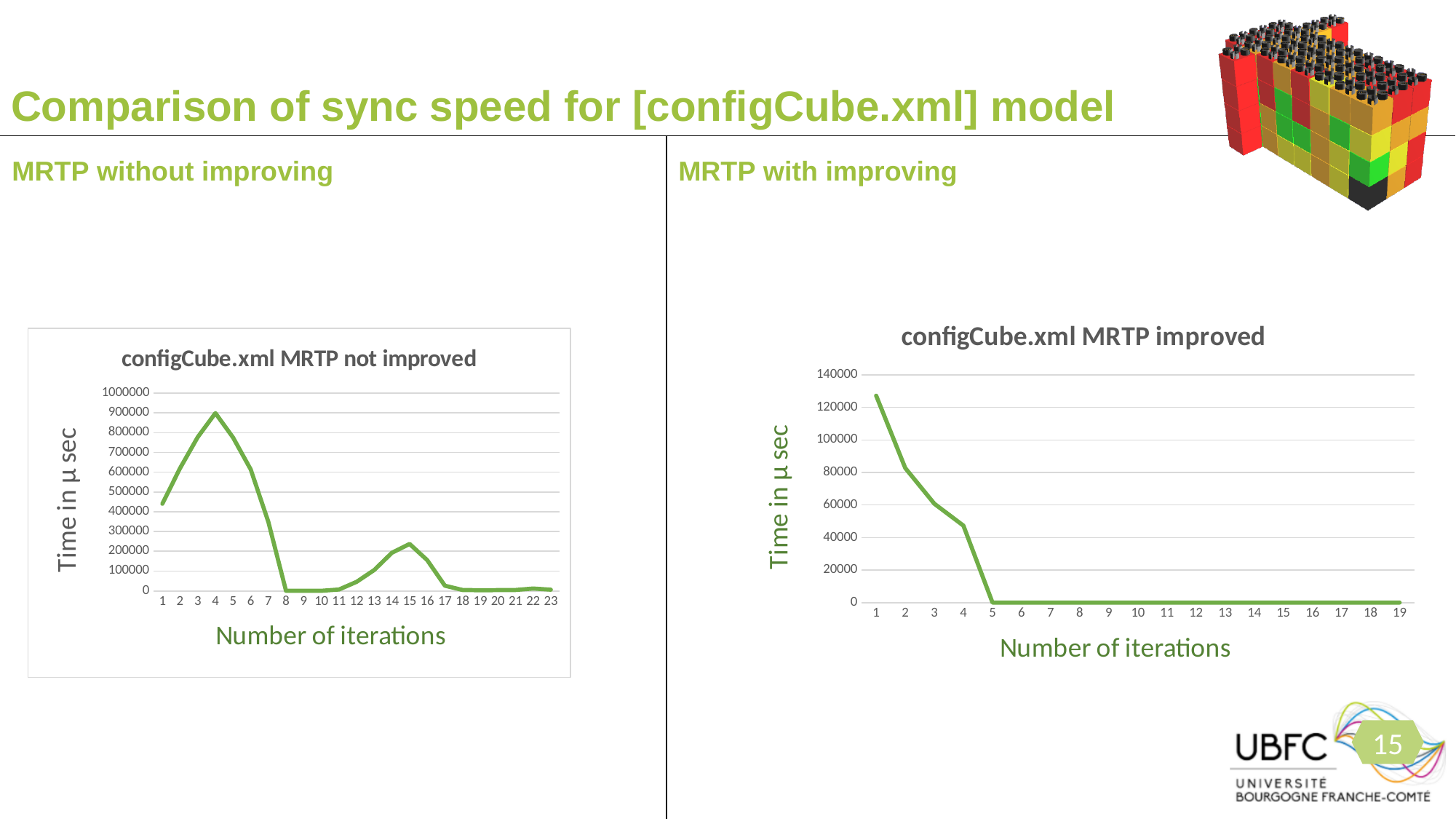
How many iterations are plotted on the x axis of the 'configCube.xml MRTP improved' chart? 19 In the 'configCube.xml MRTP not improved' chart, at which iteration is the time highest? 4 In the 'configCube.xml MRTP not improved' chart, is the value at iteration 15 greater or less than 300000? less In the 'configCube.xml MRTP improved' chart, is the value at iteration 4 greater or less than 60000? less In the 'configCube.xml MRTP improved' chart, at which iteration is the time highest? 1 In the 'configCube.xml MRTP improved' chart, is the value at iteration 1 greater or less than 120000? greater What is the y-axis label of the 'configCube.xml MRTP improved' chart? Time in µ sec In the 'configCube.xml MRTP not improved' chart, which is larger, the value at iteration 4 or the value at iteration 15? iteration 4 What kind of chart is the 'configCube.xml MRTP not improved' chart? line chart How many iterations are plotted on the x axis of the 'configCube.xml MRTP not improved' chart? 23